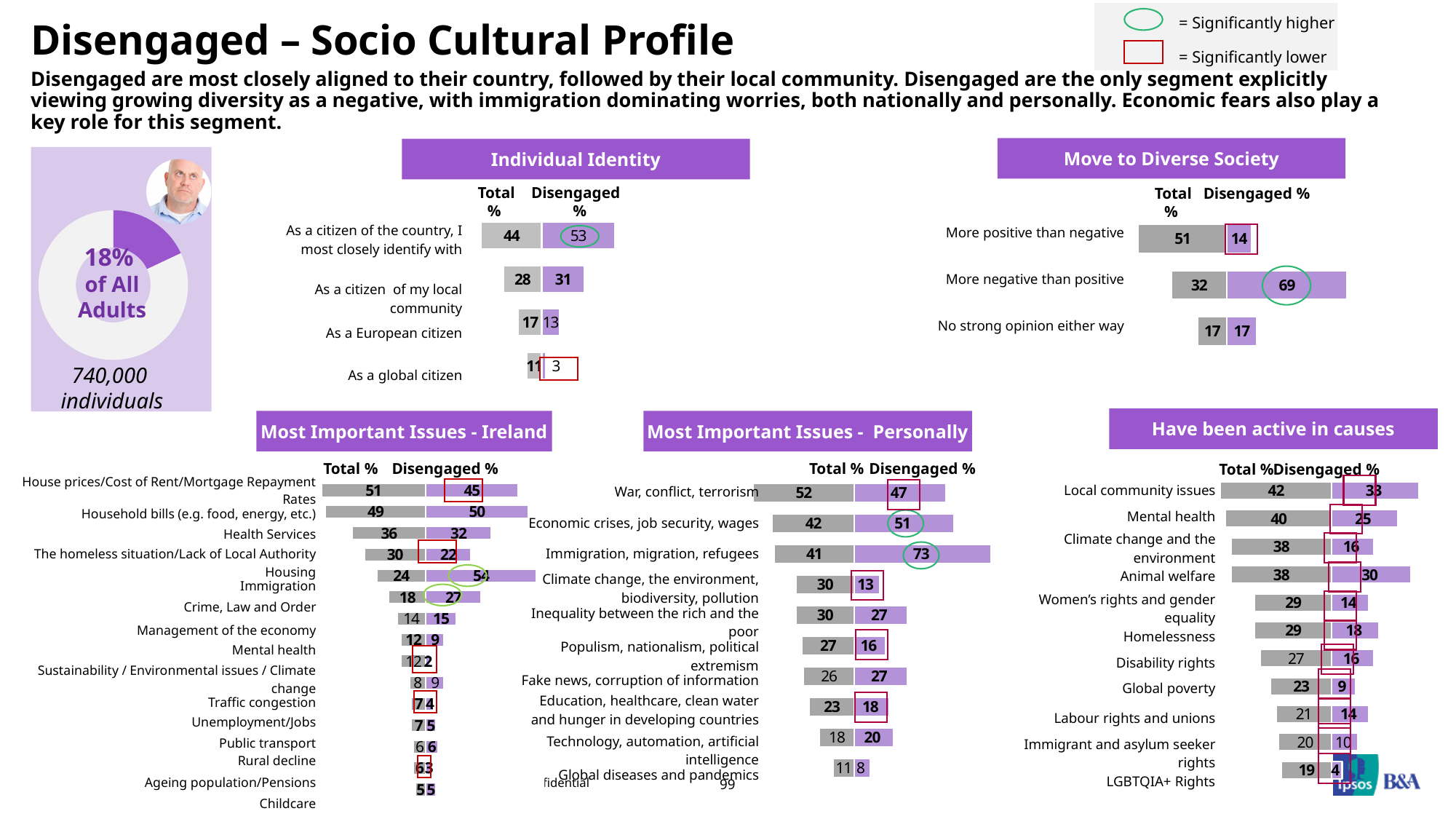
In the Individual Identity chart, what is the Disengaged % for 'As a citizen of the country, I most closely identify with'? 53 In the Individual Identity chart, what is the Total % for 'As a global citizen'? 11 What kind of chart is used for the Individual Identity section? Bar chart In the Have been active in causes chart, what is the Disengaged % for Animal welfare? 30 In the Most Important Issues - Personally chart, is the Total % or the Disengaged % larger for 'Climate change, the environment, biodiversity, pollution'? Total % In the Move to Diverse Society chart, what is the Disengaged % for 'More negative than positive'? 69 In the Move to Diverse Society chart, how many categories are shown? 3 In the Move to Diverse Society chart, what is the difference between the Total % and the Disengaged % for 'More positive than negative'? 37 In the Have been active in causes chart, which category has the lowest Disengaged %? LGBTQIA+ Rights In the Most Important Issues - Ireland chart, which category has the highest Total %? House prices/Cost of Rent/Mortgage Repayment Rates In the Most Important Issues - Personally chart, which category has the highest Disengaged %? Immigration, migration, refugees In the Most Important Issues - Ireland chart, what is the Disengaged % for Immigration? 54